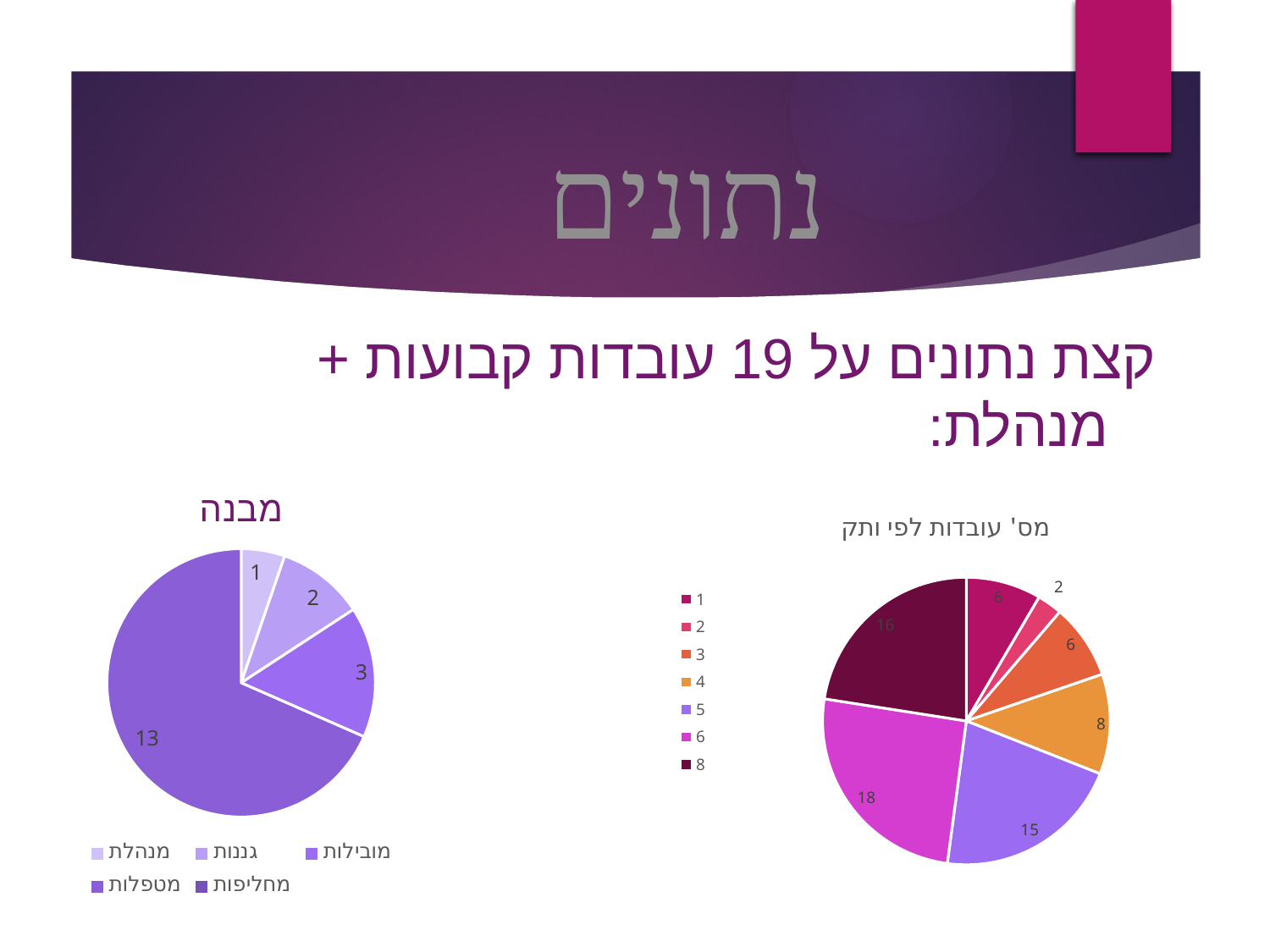
In the chart titled 'מס' עובדות לפי ותק', what is the value for seniority category 4? 8 In the chart titled 'מבנה', what is the value of the smallest slice? 1 In the chart titled 'מס' עובדות לפי ותק', which seniority category has the smallest slice? 2 In the chart titled 'מבנה' on the left of the slide, what is the value of the largest slice? 13 In the chart titled 'מס' עובדות לפי ותק', which seniority category has the largest slice? 6 How many entries does the legend of the chart titled 'מס' עובדות לפי ותק' list? 7 In the chart titled 'מבנה', what is the value for 'מנהלת'? 1 In the chart titled 'מס' עובדות לפי ותק', what is the value for seniority category 5? 15 In the chart titled 'מס' עובדות לפי ותק', what is the difference between the values for seniority categories 6 and 5? 3 How many entries does the legend of the chart titled 'מבנה' list? 5 In the chart titled 'מס' עובדות לפי ותק', which is larger: the value for seniority category 8 or for category 4? 8 What kind of chart is the chart titled 'מס' עובדות לפי ותק' on the right of the slide? pie chart